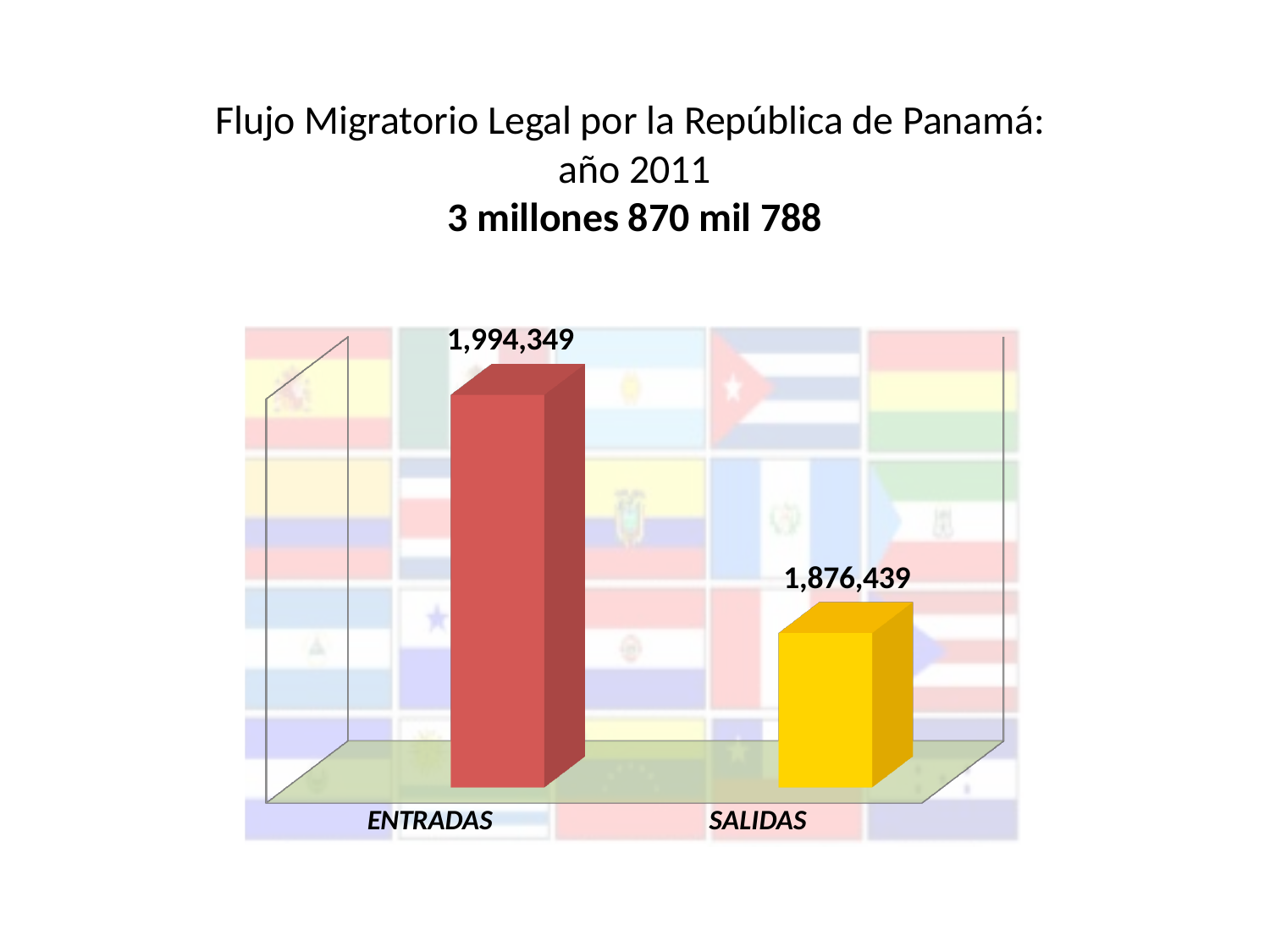
What colour is the bar for ENTRADAS? red Which category has the lowest value? SALIDAS What is the value for ENTRADAS? 1,994,349 What is the total of the two values shown in the chart? 3,870,788 What is the difference between the values for ENTRADAS and SALIDAS? 117,910 Which category has the highest value? ENTRADAS How many categories are shown in the chart? 2 Which is larger, ENTRADAS or SALIDAS? ENTRADAS What colour is the bar for SALIDAS? yellow What is the value for SALIDAS? 1,876,439 What kind of chart is shown on the slide? bar chart